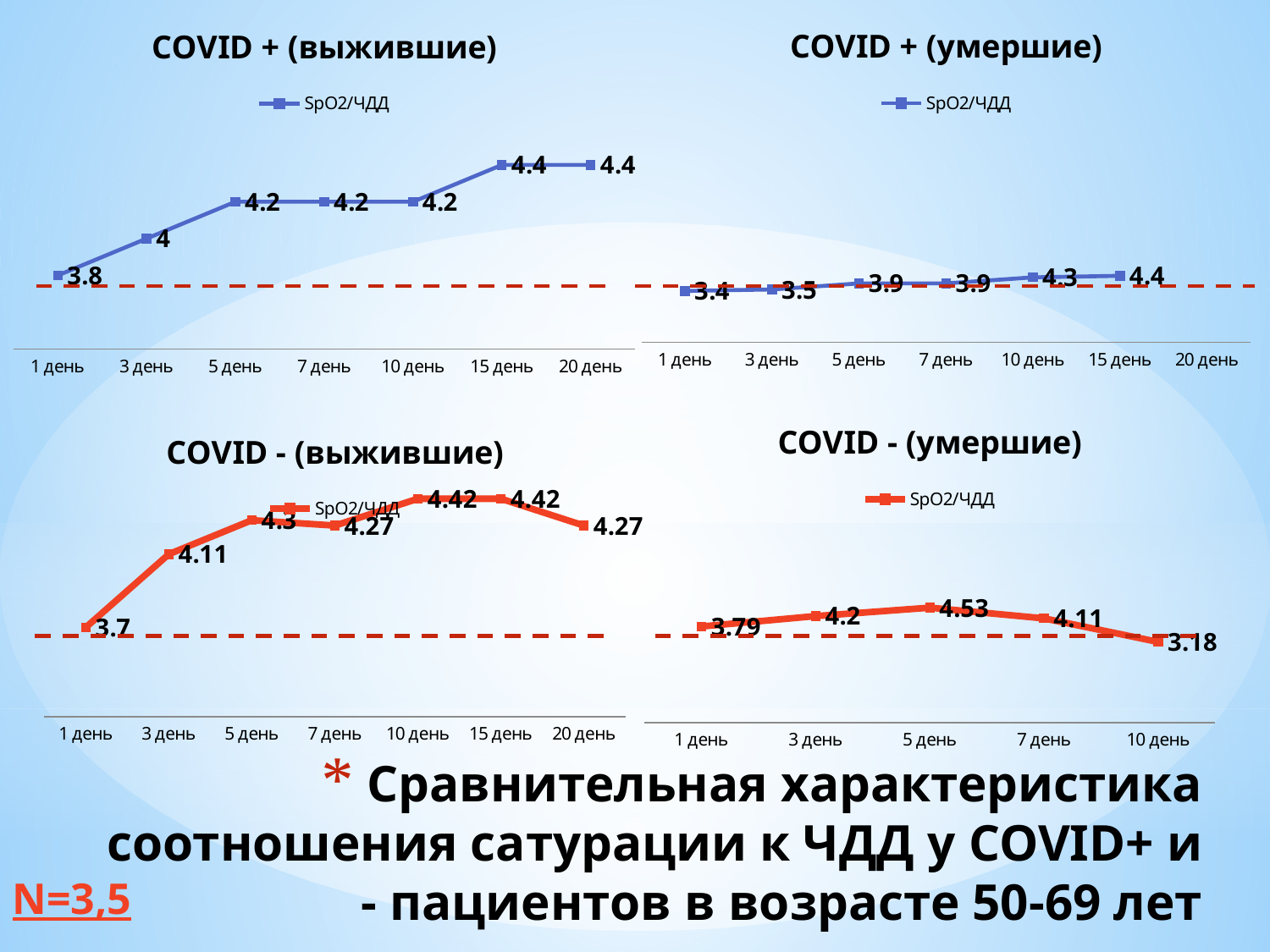
What type of chart is "COVID + (выжившие)"? Line chart In the "COVID + (выжившие)" chart, what is the SpO2/ЧДД value on 1 день? 3.8 In the "COVID - (выжившие)" chart, which day has the lowest value? 1 день In the "COVID + (выжившие)" chart, what is the value on 15 день? 4.4 In the "COVID - (умершие)" chart, which day has the highest value? 5 день In the "COVID + (умершие)" chart, what is the value on 1 день? 3.4 In the "COVID - (умершие)" chart, how many data points are plotted? 5 In the "COVID - (умершие)" chart, what is the value on 10 день? 3.18 In the "COVID - (выжившие)" chart, what is the value on 3 день? 4.11 In the "COVID + (умершие)" chart, what is the difference between the values on 15 день and 1 день? 1 In the "COVID - (умершие)" chart, which is larger: the value on 3 день or on 7 день? 3 день What series name does the legend show in the "COVID - (умершие)" chart? SpO2/ЧДД